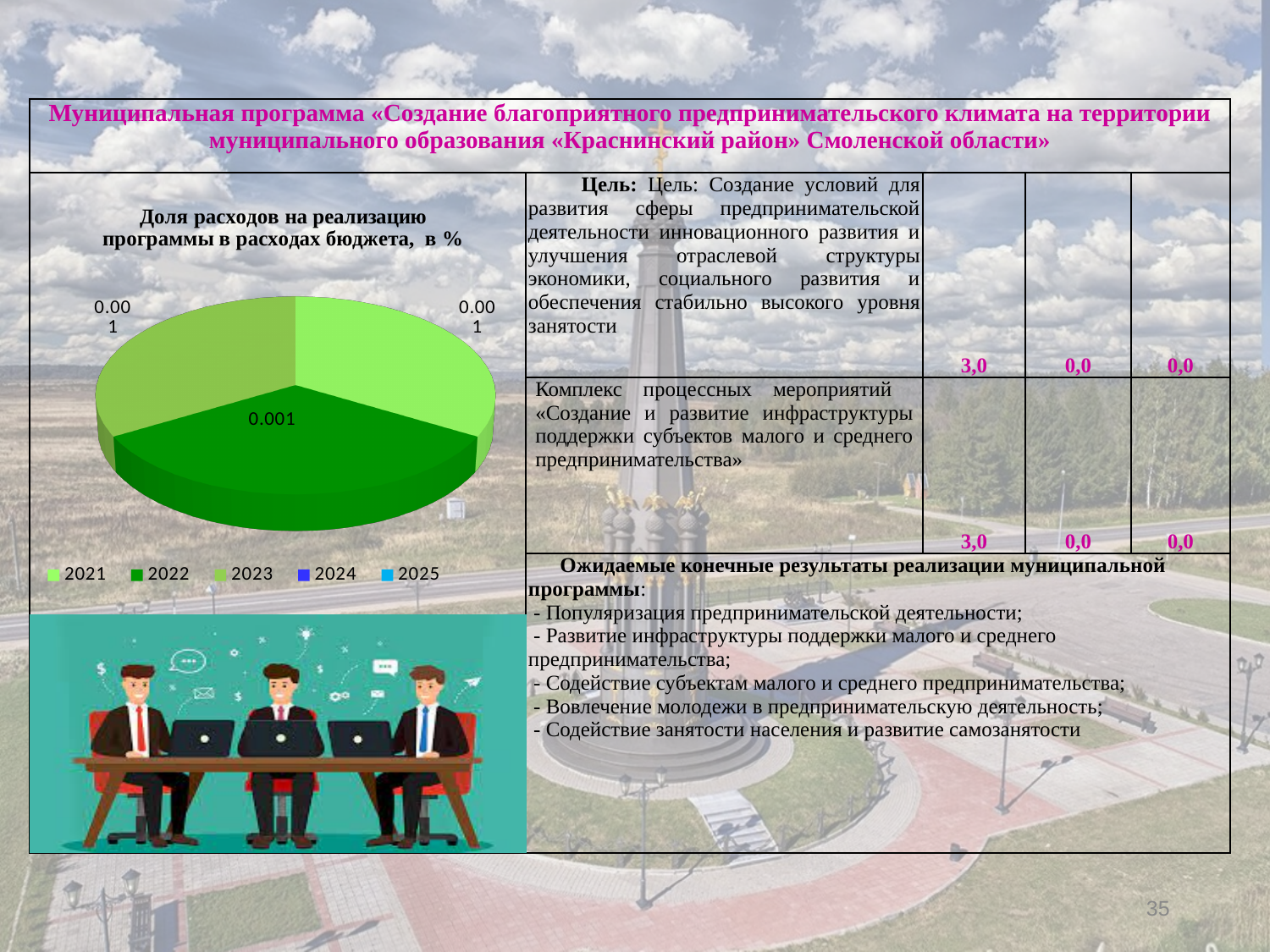
Are the three labelled slices of the pie chart equal in value? yes Is the value printed on the dark green slice of the pie chart greater or less than 1? less What value is printed on the top-left slice of the pie chart? 0.001 What kind of chart is shown on the left of the slide? pie chart How many slices are visible in the pie chart? 3 What value is printed on the top-right slice of the pie chart? 0.001 How many entries does the legend of the pie chart list? 5 What is the title of the pie chart? Доля расходов на реализацию программы в расходах бюджета, в % Which years are listed in the legend of the pie chart? 2021, 2022, 2023, 2024, 2025 What value is printed on the dark green slice of the pie chart? 0.001